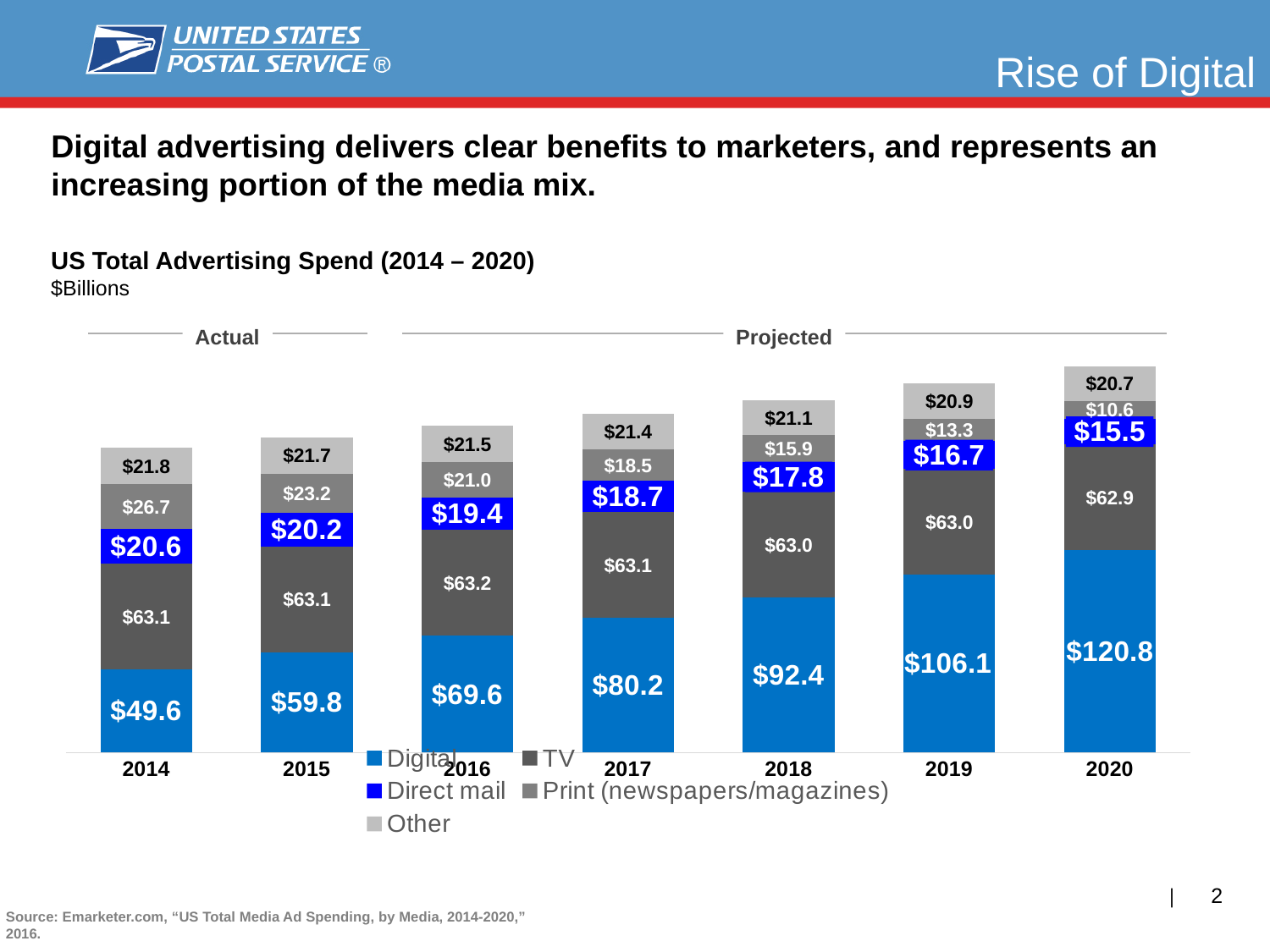
What kind of chart is shown on the slide? Stacked bar chart What is the Direct mail spend for 2017? $18.7 What is the difference between Digital spend in 2020 and Digital spend in 2014? $71.2 How many series does the legend list? 5 What is the projected Digital advertising spend for 2020? $120.8 Does Direct mail spend rise or fall from 2014 to 2020? Fall What is the Digital advertising spend for 2014? $49.6 How many years are shown on the x axis? 7 In which year is Print (newspapers/magazines) spend lowest? 2020 Which is larger in 2016: Digital spend or TV spend? Digital What is the Print (newspapers/magazines) spend for 2020? $10.6 In which year is Digital spend highest? 2020